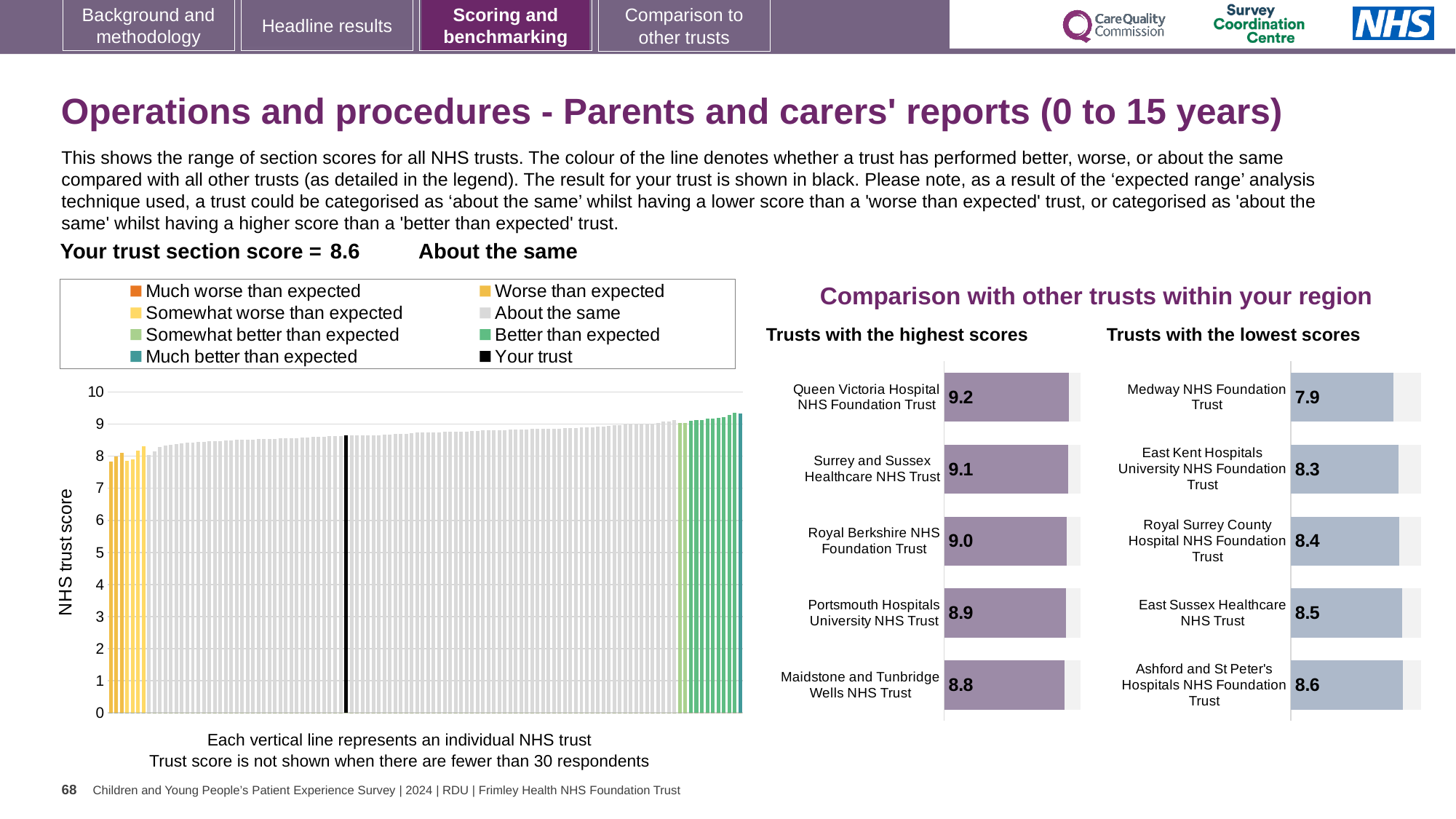
How many entries does the legend above the large chart on the left list? 8 In the 'Trusts with the highest scores' chart, what is the score for Queen Victoria Hospital NHS Foundation Trust? 9.2 What kind of chart is the large chart on the left with the 'NHS trust score' axis? Bar chart In the 'Trusts with the highest scores' chart, what is the score for Royal Berkshire NHS Foundation Trust? 9.0 In the 'Trusts with the highest scores' chart, what is the difference between the scores of Queen Victoria Hospital NHS Foundation Trust and Portsmouth Hospitals University NHS Trust? 0.3 In the 'Trusts with the lowest scores' chart, which trust has the highest score? Ashford and St Peter's Hospitals NHS Foundation Trust In the 'Trusts with the lowest scores' chart, what is the score for East Sussex Healthcare NHS Trust? 8.5 In the large chart on the left, is the value of the highest green bar greater or less than 9? greater How many trusts are shown in the 'Trusts with the lowest scores' chart? 5 In the 'Trusts with the lowest scores' chart, what is the score for Medway NHS Foundation Trust? 7.9 In the 'Trusts with the highest scores' chart, which trust has the lowest score? Maidstone and Tunbridge Wells NHS Trust In the 'Trusts with the lowest scores' chart, which has the larger score: East Kent Hospitals University NHS Foundation Trust or Royal Surrey County Hospital NHS Foundation Trust? Royal Surrey County Hospital NHS Foundation Trust